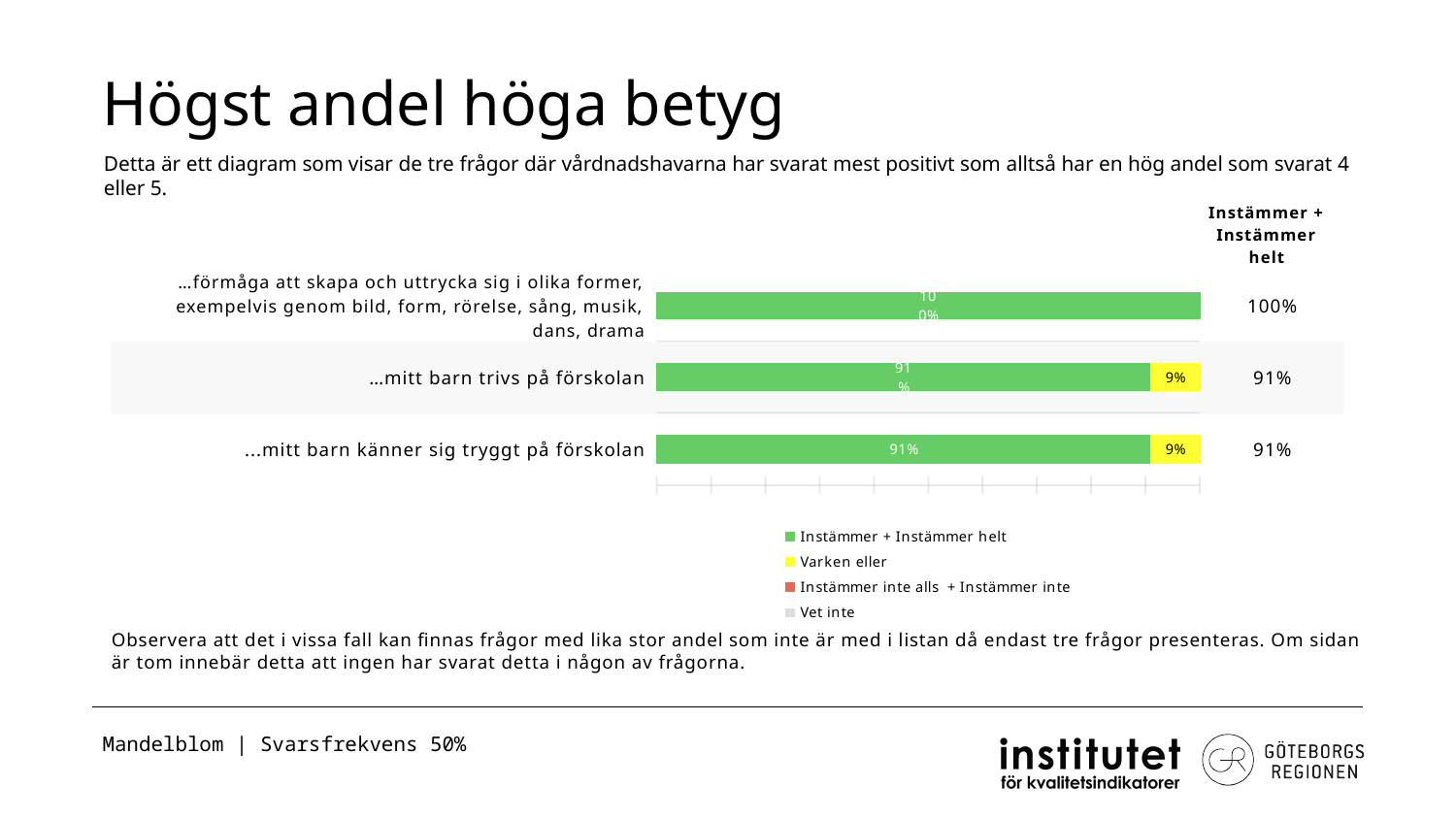
How many series does the chart legend list? 4 Which is larger: the 'Instämmer + Instämmer helt' share for '…förmåga att skapa och uttrycka sig i olika former…' or for '...mitt barn känner sig tryggt på förskolan'? …förmåga att skapa och uttrycka sig i olika former… Which question has the highest 'Instämmer + Instämmer helt' share? …förmåga att skapa och uttrycka sig i olika former, exempelvis genom bild, form, rörelse, sång, musik, dans, drama Which legend entry is shown in yellow? Varken eller What kind of chart is shown on the slide? Stacked bar chart What is the 'Instämmer + Instämmer helt' share for '…förmåga att skapa och uttrycka sig i olika former, exempelvis genom bild, form, rörelse, sång, musik, dans, drama'? 100% How many questions (categories) are plotted in the chart? 3 What is the total of the stacked bar for '…mitt barn trivs på förskolan'? 100% What is the heading of the column of values to the right of the bars? Instämmer + Instämmer helt What is the difference in 'Instämmer + Instämmer helt' share between '…förmåga att skapa och uttrycka sig i olika former…' and '…mitt barn trivs på förskolan'? 9% What is the 'Varken eller' share for '...mitt barn känner sig tryggt på förskolan'? 9% What is the 'Instämmer + Instämmer helt' share for '…mitt barn trivs på förskolan'? 91%